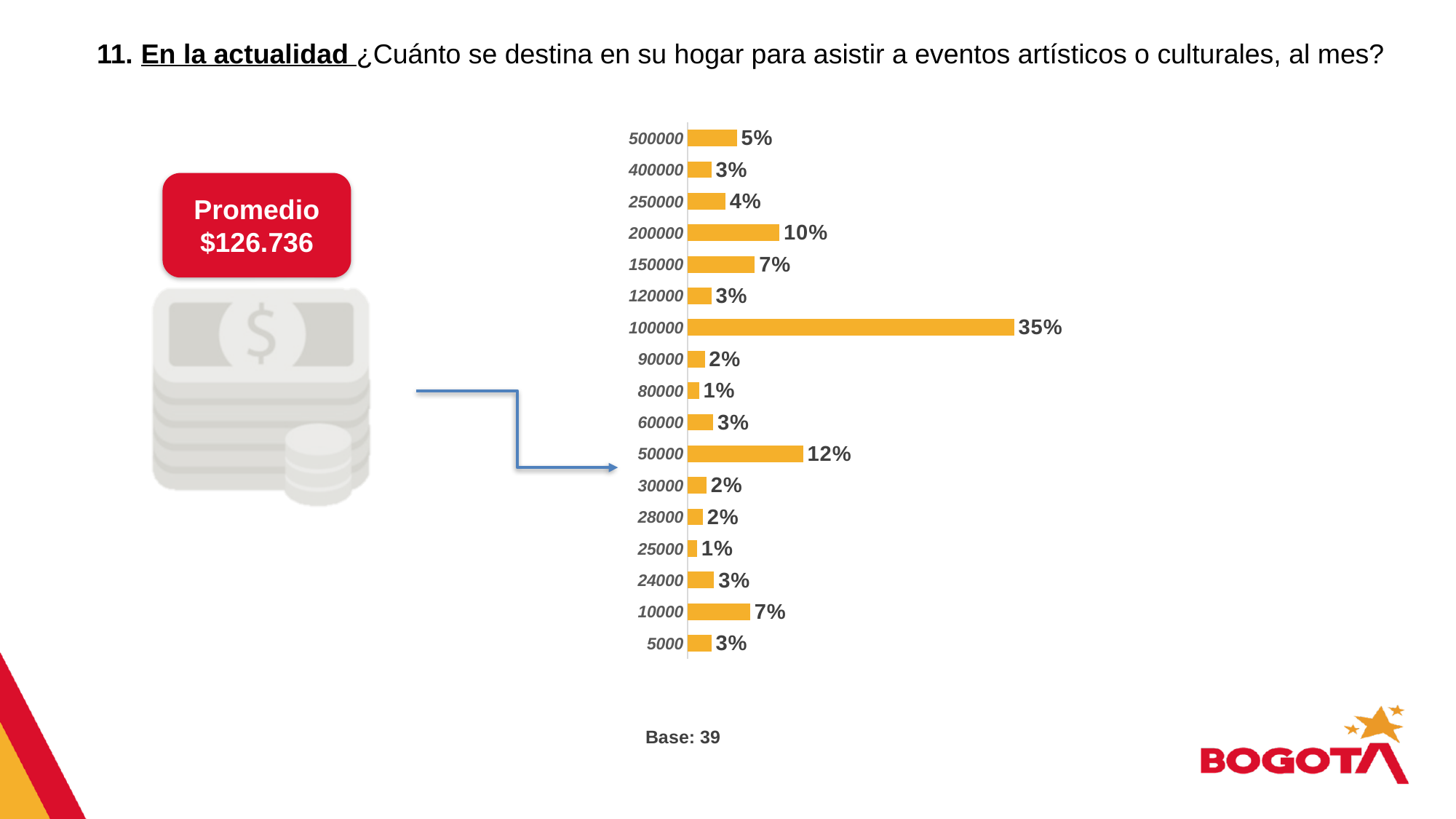
Which has a larger value, 250000 or 400000? 250000 What is the value for the 500000 category? 5% What percentage of households spend 100000 per month on artistic or cultural events? 35% What percentage is shown for the 200000 category? 10% What is the difference between the percentages for 100000 and 50000? 23% How many categories are shown in the chart? 17 What is the value shown for the 50000 category? 12% Which category has the highest percentage? 100000 What average (Promedio) value is shown in the red box on the slide? $126.736 What is the difference between the values for 200000 and 150000? 3% What kind of chart is shown on the slide? Bar chart Which has a larger value, 10000 or 5000? 10000